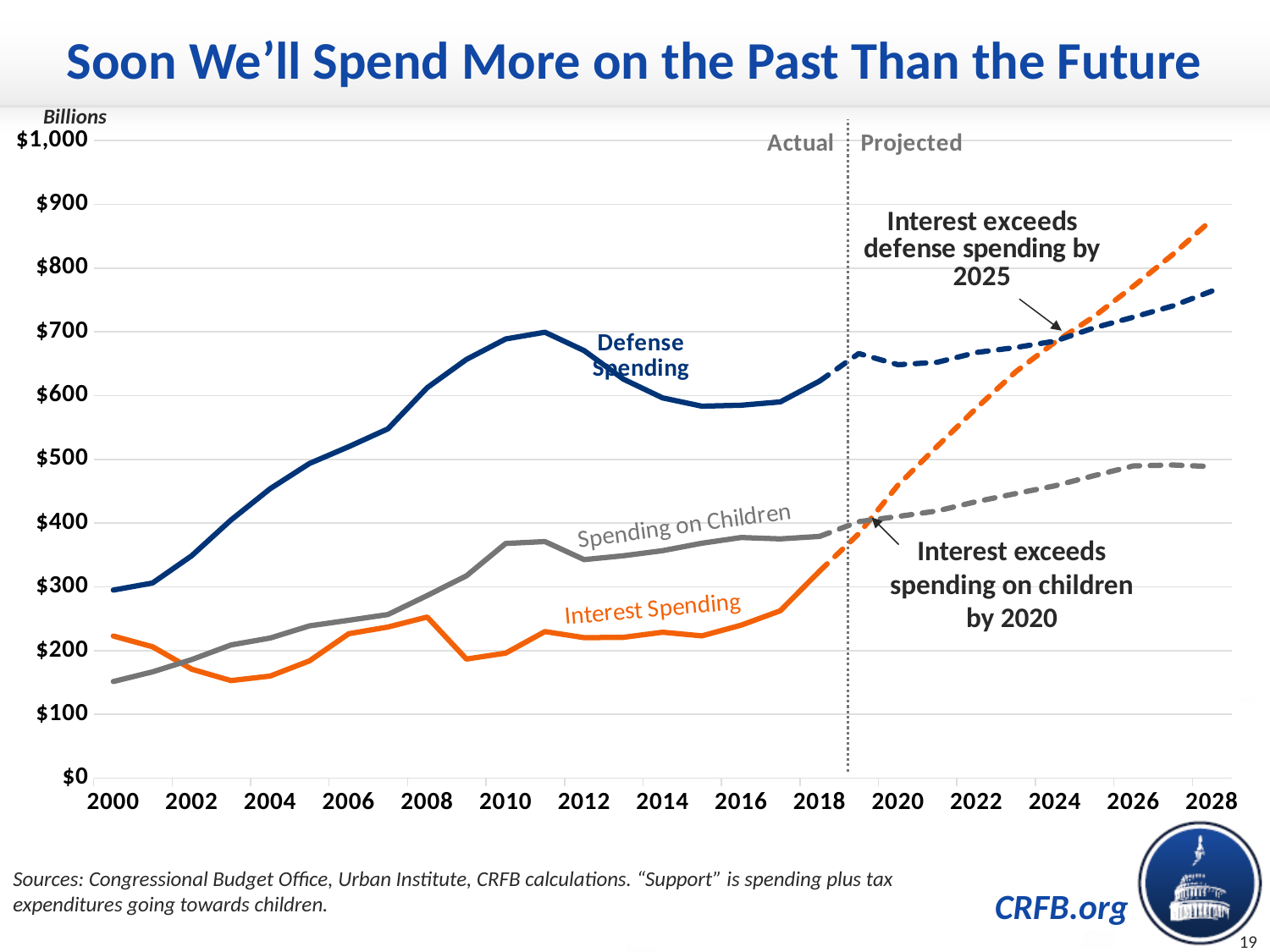
Is the value for Defense Spending in 2028 greater or less than $700? greater Is the value for Interest Spending in 2003 greater or less than $200? less Is the value for Interest Spending in 2028 greater or less than $800? greater Which series has the highest value in 2028? Interest Spending How many spending series are plotted on the chart? 3 In 2010, which is larger: Spending on Children or Interest Spending? Spending on Children What kind of chart is shown on the slide? Line chart Which series has the lowest value in 2028? Spending on Children According to the annotation, in what year does interest exceed defense spending? 2025 What is the title of the slide? Soon We'll Spend More on the Past Than the Future Does Interest Spending rise or fall between 2018 and 2028? Rise